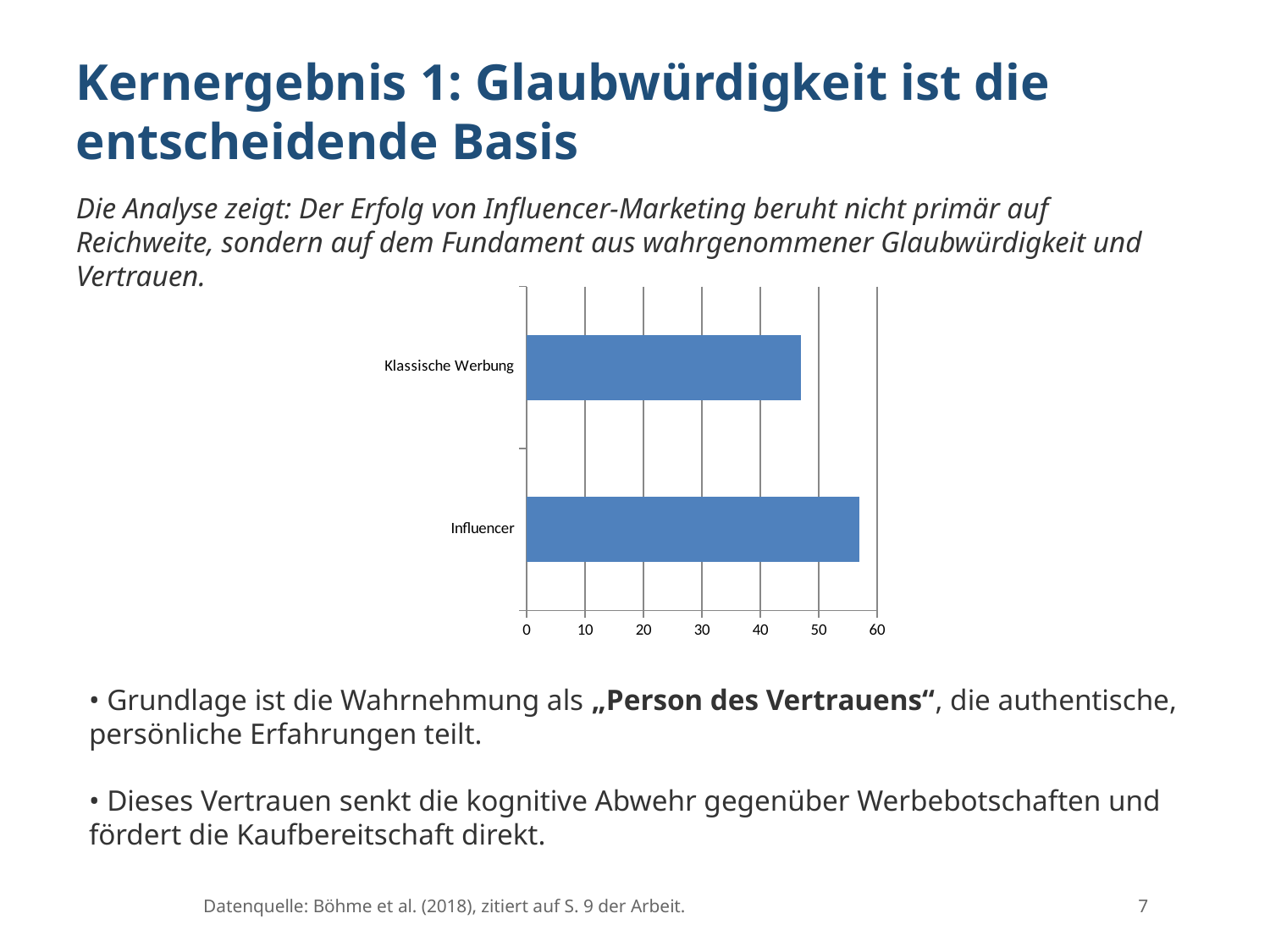
Is the value for Influencer greater or less than 60? less Which category has the highest value in the chart? Influencer What is the highest value shown on the chart's horizontal axis? 60 Is the value for Klassische Werbung greater or less than 50? less Is the value for Klassische Werbung greater or less than 40? greater How many categories does the chart show? 2 What kind of chart is shown on the slide? bar chart Which category has the lowest value in the chart? Klassische Werbung Which is larger, the value for Influencer or the value for Klassische Werbung? Influencer What colour are the bars in the chart? blue